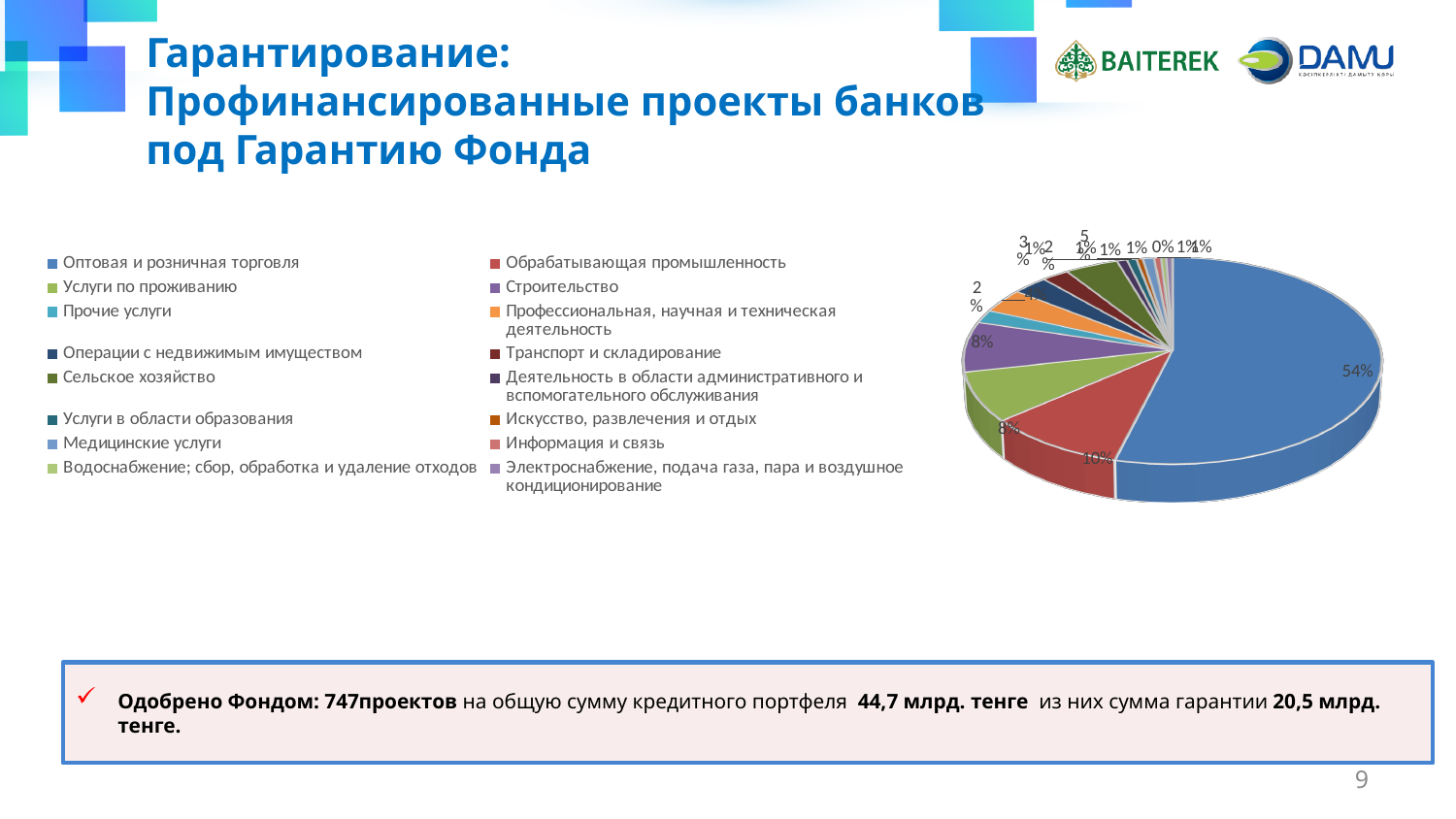
By how many percentage points does the share of Оптовая и розничная торговля exceed that of Обрабатывающая промышленность? 44 percentage points What colour is the slice for Оптовая и розничная торговля? Blue Which has a larger share: Обрабатывающая промышленность or Услуги по проживанию? Обрабатывающая промышленность What share of the pie does Строительство have? 8% What is the title of the slide containing the pie chart? Гарантирование: Профинансированные проекты банков под Гарантию Фонда How many categories does the legend of the pie chart list? 16 What share of the pie does Обрабатывающая промышленность have? 10% Is the share of Оптовая и розничная торговля greater or less than 50%? greater What share of the pie does Услуги по проживанию have? 8% Which category has the largest slice of the pie chart? Оптовая и розничная торговля What kind of chart is shown on the slide? Pie chart